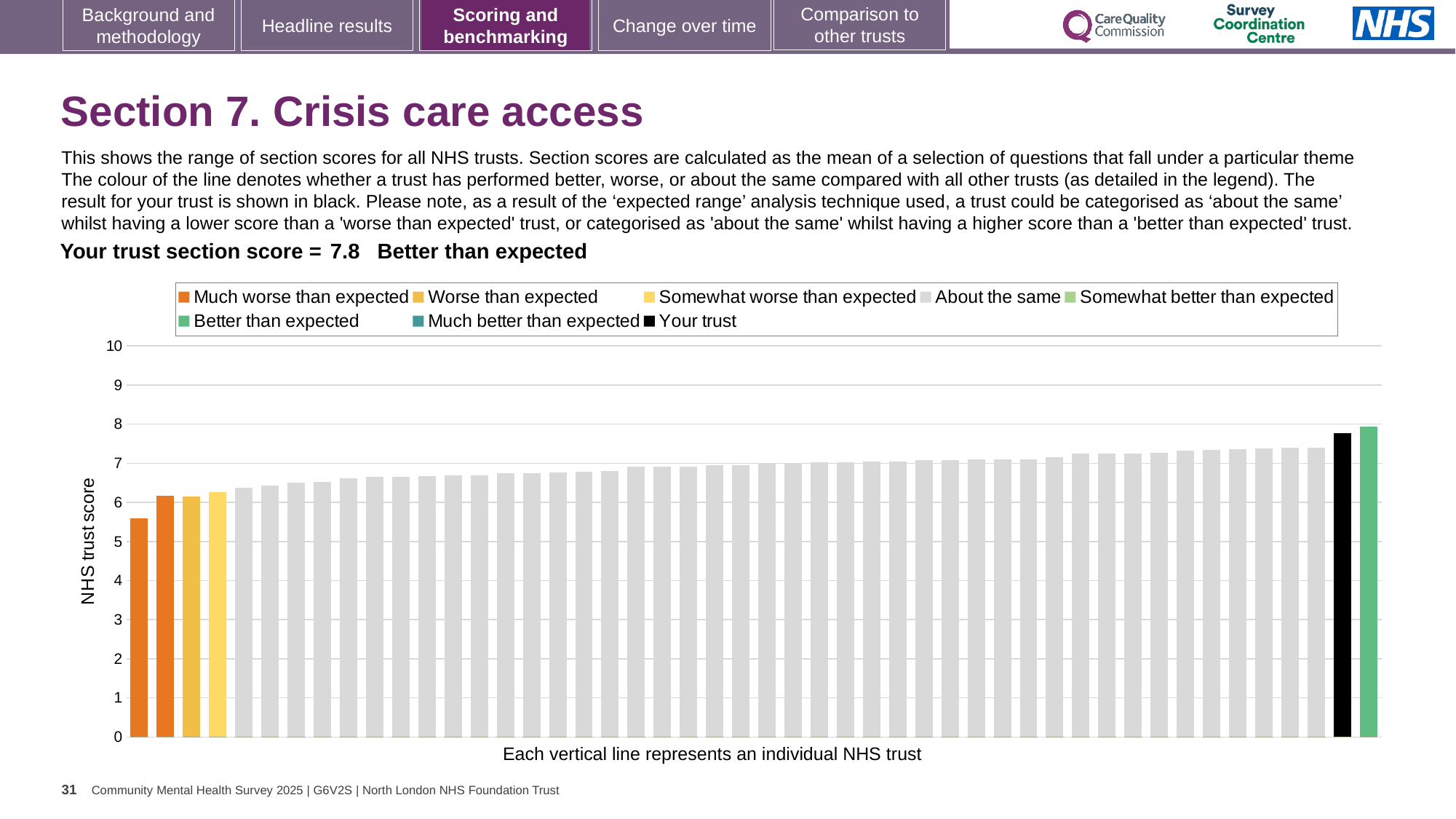
Which performance category is your trust placed in for crisis care access? Better than expected What is the section score for your trust? 7.8 Is the value of the black 'Your trust' bar greater or less than 7? greater How many entries does the chart legend list? 8 Do the bar values rise or fall from left to right along the x axis? rise How many bars are coloured as 'Much worse than expected' (orange)? 2 Is the value of the rightmost bar greater or less than 7? greater What kind of chart is shown on the slide? Bar chart What is the label on the vertical axis of the chart? NHS trust score Which legend category does the highest bar on the chart belong to? Better than expected Which legend category does the lowest bar on the chart belong to? Much worse than expected Is the value of the leftmost (lowest) bar greater or less than 6? less